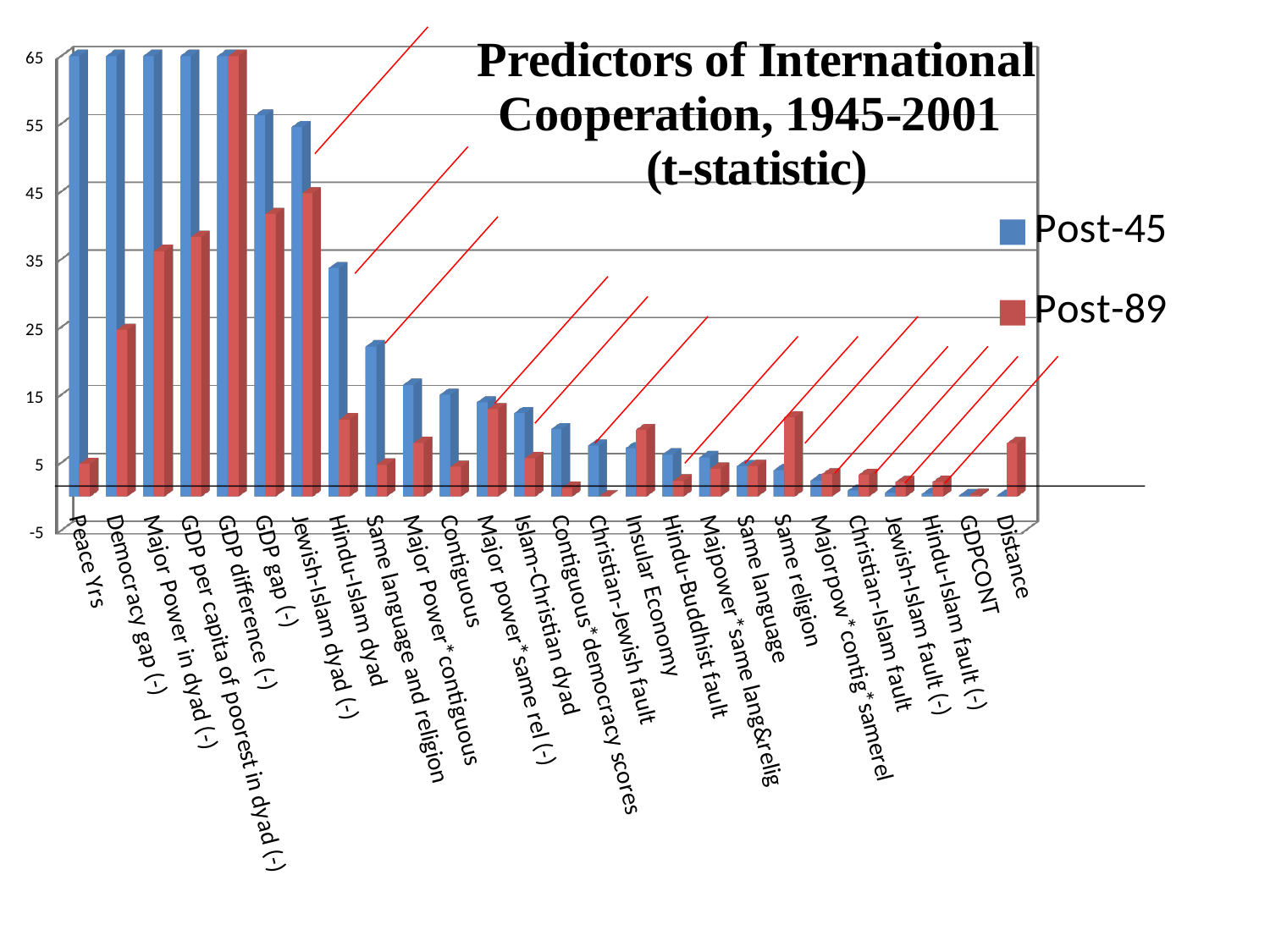
Is the Post-89 value for Same religion greater or less than 5? greater Is the Post-45 value for Same language and religion greater or less than 15? greater Is the Post-45 value for Peace Yrs greater or less than 55? greater For Peace Yrs, which series has the larger value, Post-45 or Post-89? Post-45 What kind of chart is shown on the slide? bar chart What is the title of the chart? Predictors of International Cooperation, 1945-2001 (t-statistic) What are the two series named in the legend? Post-45 and Post-89 How many categories are shown on the x axis? 26 Which category has the highest Post-89 value? GDP difference (-) How many series does the legend list? 2 For Same religion, which series has the larger value, Post-45 or Post-89? Post-89